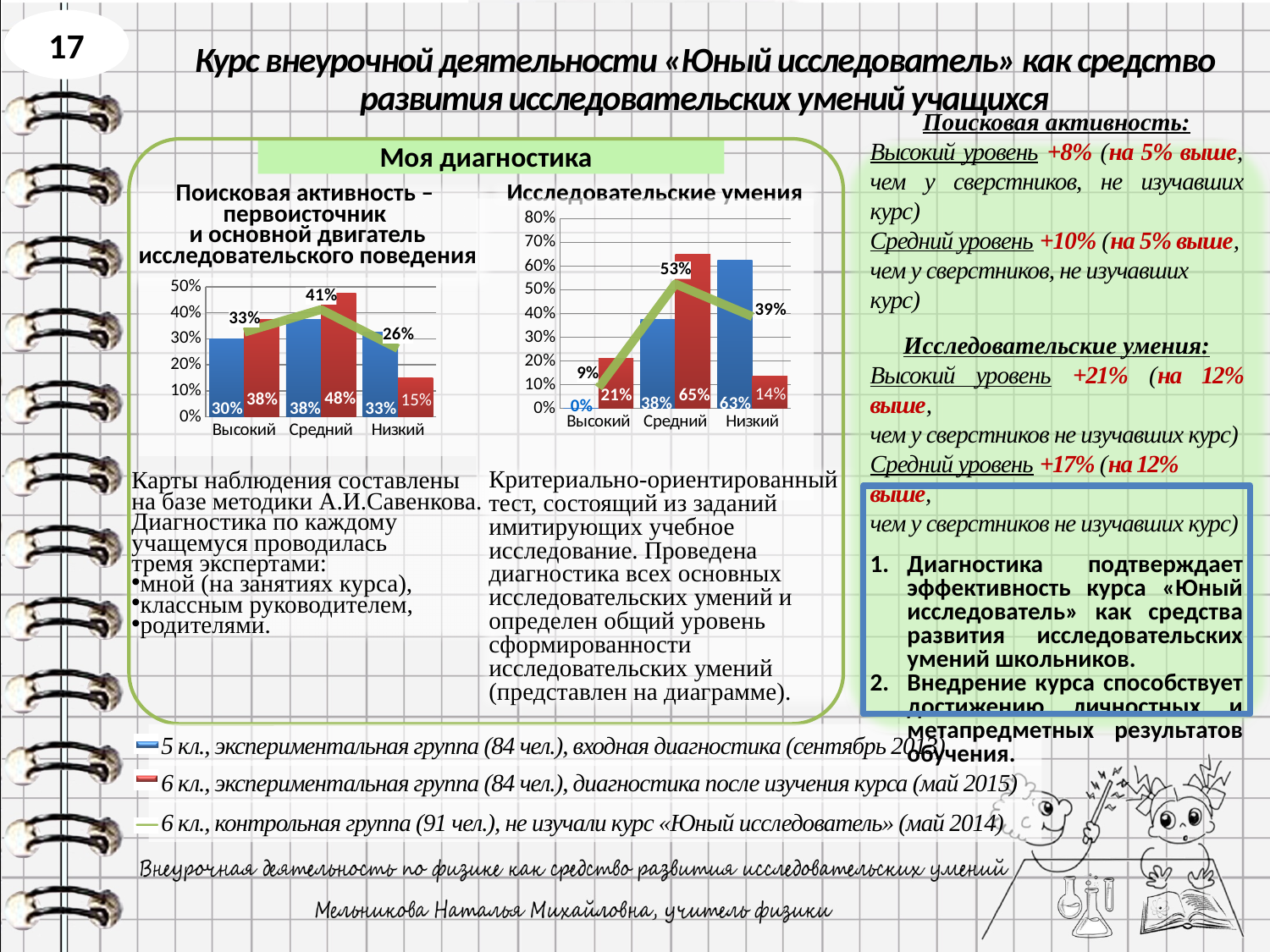
What kind of chart is the chart titled «Поисковая активность»? bar chart with a line How many series does the legend at the bottom of the slide list for the charts? 3 In the chart titled «Поисковая активность», what value does the green line show for the «Высокий» category? 33% In the chart titled «Исследовательские умения», what is the value of the blue bar for the «Низкий» category? 63% In the chart titled «Поисковая активность», what is the value of the red bar for the «Средний» category? 48% In the chart titled «Исследовательские умения», what value does the green line show for the «Низкий» category? 39% In the chart titled «Поисковая активность», which is larger for the «Низкий» category: the blue bar or the red bar? the blue bar In the chart titled «Исследовательские умения», what is the value of the red bar for the «Средний» category? 65% In the chart titled «Поисковая активность», which category has the lowest red bar? Низкий In the chart titled «Исследовательские умения», which category has the highest red bar? Средний In the chart titled «Исследовательские умения», what is the difference between the red bar and the blue bar for the «Высокий» category? 21% How many categories are shown on the x axis of the chart titled «Исследовательские умения»? 3